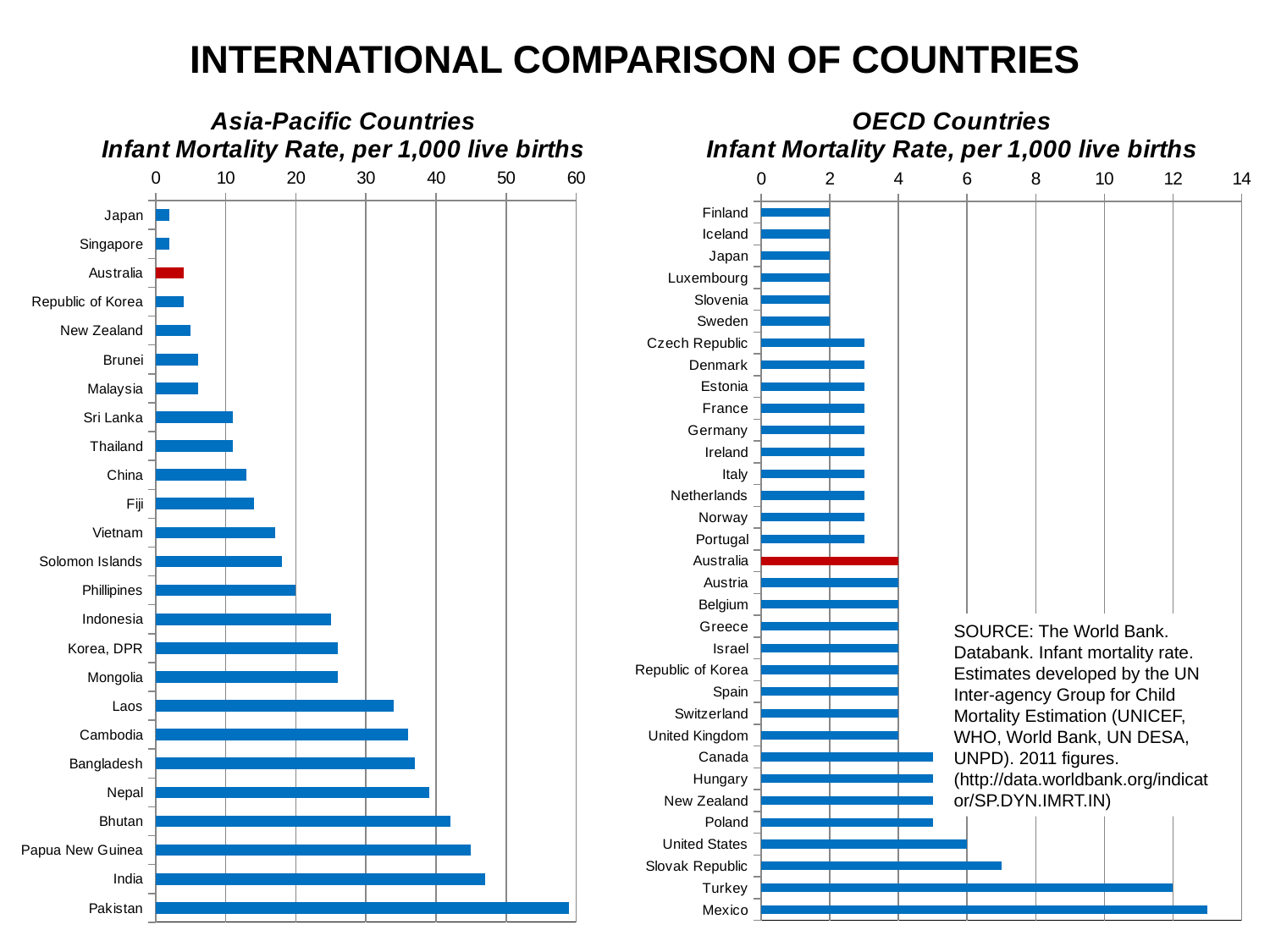
In the Asia-Pacific Countries chart, is the value for Pakistan greater or less than 50? greater In the Asia-Pacific Countries chart, which has a higher infant mortality rate, India or Pakistan? Pakistan In the OECD Countries chart, what is the infant mortality rate for Turkey? 12 What kind of chart is the Asia-Pacific Countries chart on the left? bar chart In the OECD Countries chart, what is the infant mortality rate for Finland? 2 In the OECD Countries chart, which country has the highest infant mortality rate? Mexico How many countries are shown in the Asia-Pacific Countries chart? 25 In the OECD Countries chart, is the value for the United States greater or less than 4? greater In the Asia-Pacific Countries chart, is the value for Laos greater or less than 30? greater In the Asia-Pacific Countries chart, which country has the highest infant mortality rate? Pakistan In the OECD Countries chart, which country's bar is coloured red? Australia In the OECD Countries chart, what is the infant mortality rate for Australia? 4